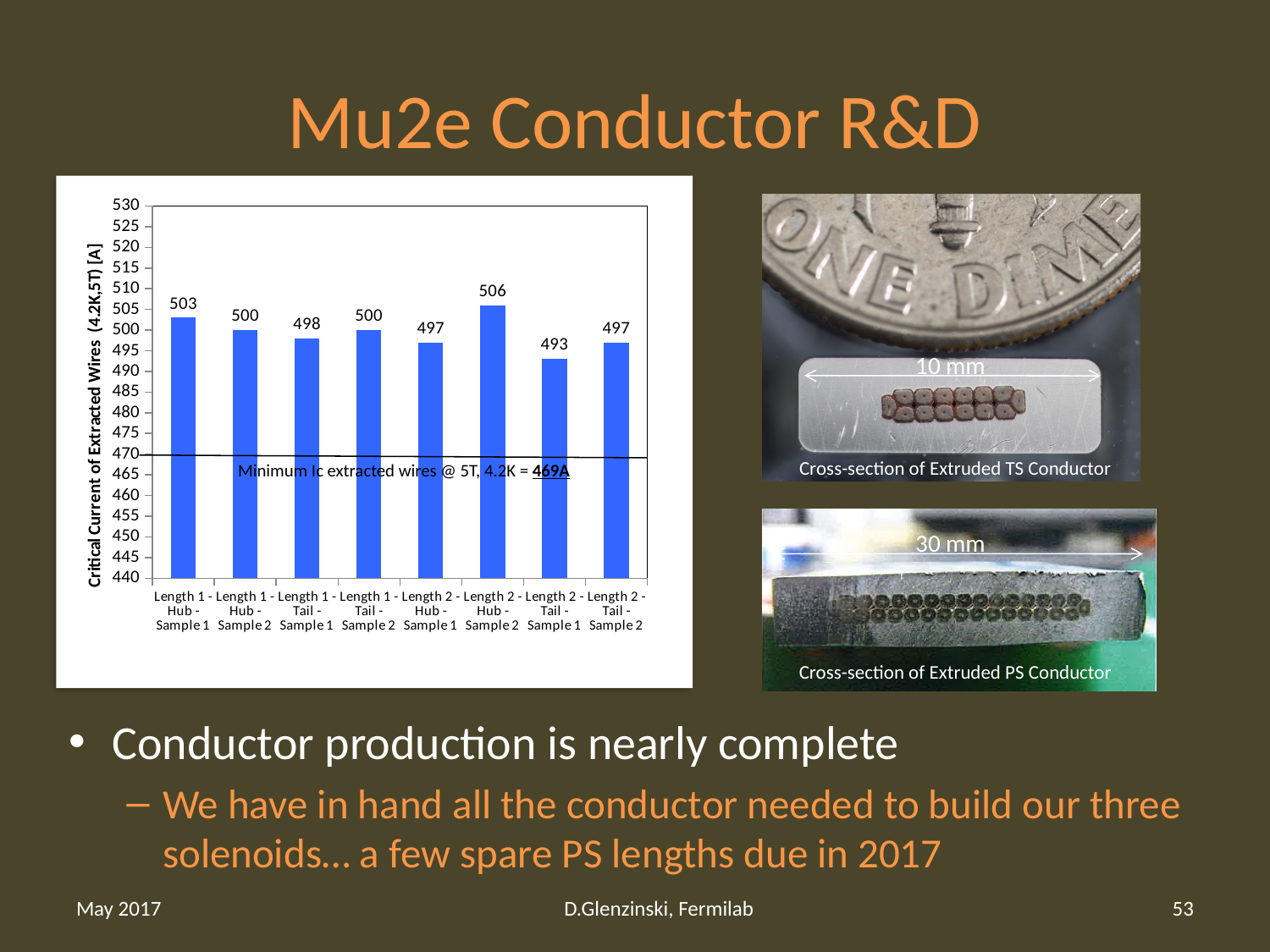
What is the critical current for Length 2 - Tail - Sample 1? 493 What minimum Ic value for extracted wires at 5T, 4.2K is marked on the chart? 469A Which category has the lowest critical current? Length 2 - Tail - Sample 1 How many bars are plotted in the chart? 8 What is the label of the vertical axis of the chart? Critical Current of Extracted Wires (4.2K,5T) [A] What is the critical current for Length 2 - Hub - Sample 2? 506 What is the critical current for Length 1 - Hub - Sample 1? 503 Which has a larger critical current, Length 1 - Hub - Sample 1 or Length 1 - Tail - Sample 1? Length 1 - Hub - Sample 1 What kind of chart is shown on the slide? bar chart Is the value for Length 2 - Tail - Sample 1 greater or less than 470? greater Which category has the highest critical current? Length 2 - Hub - Sample 2 What is the difference between the critical current of Length 2 - Hub - Sample 2 and Length 2 - Tail - Sample 1? 13